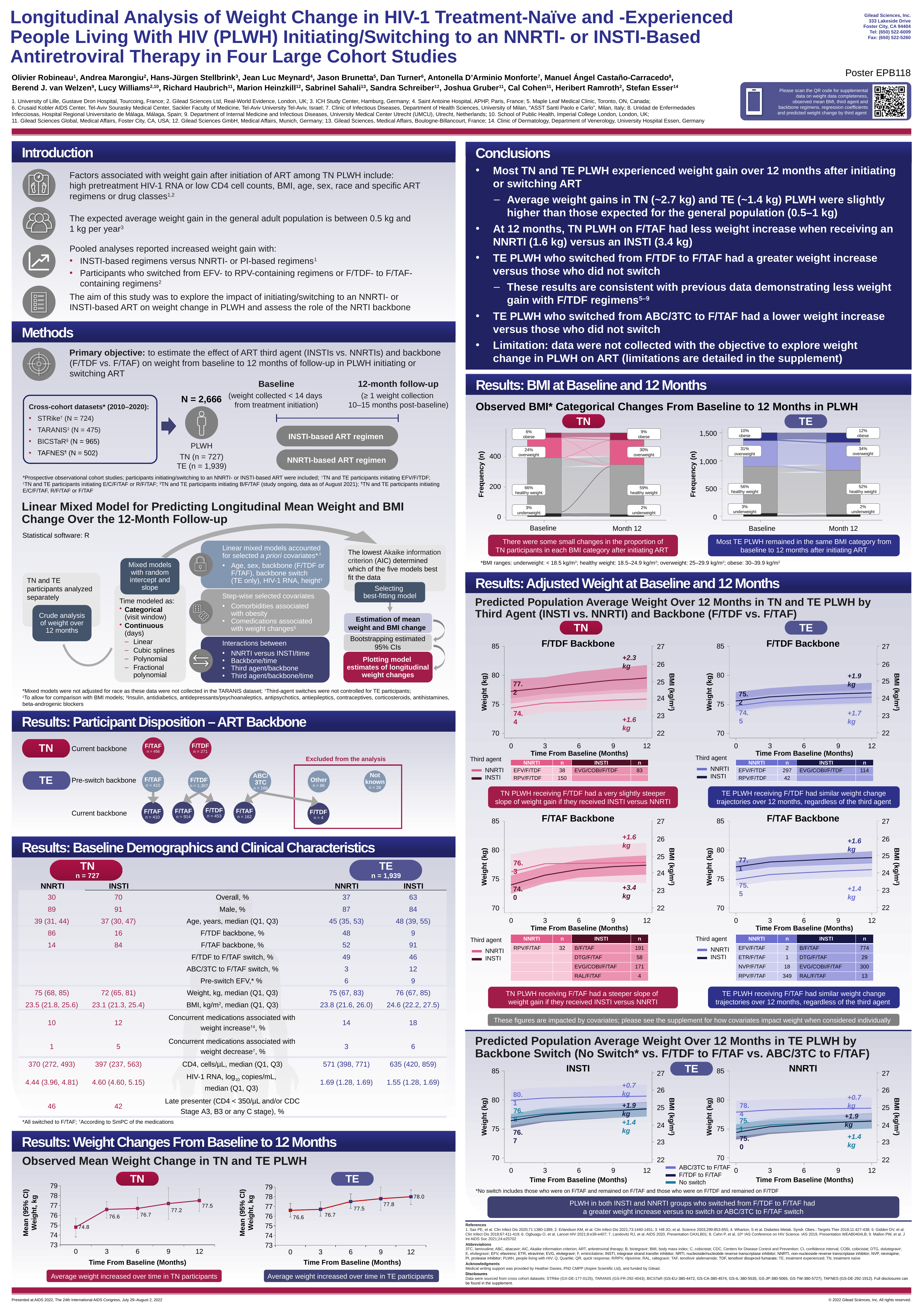
In the 'Observed Mean Weight Change in TN and TE PLWH' TN chart, what is the mean weight at month 12? 77.5 In the 'Observed Mean Weight Change in TN and TE PLWH' TN chart, how many time points are plotted? 5 In the 'Observed Mean Weight Change in TN and TE PLWH' TE chart, what is the mean weight at month 12? 78.0 What kind of chart is the 'Observed Mean Weight Change in TN and TE PLWH' TN chart? line chart In the 'Observed BMI Categorical Changes' TE chart, what percentage of participants were healthy weight at Baseline? 56% In the 'Observed Mean Weight Change in TN and TE PLWH' TE chart, does the mean weight rise or fall from month 0 to month 12? rise In the 'Predicted Population Average Weight Over 12 Months in TE PLWH by Backbone Switch' INSTI chart, what is the weight change for the F/TDF to F/TAF group? +1.9 kg In the 'Observed BMI Categorical Changes' TN chart, what percentage of participants were overweight at Month 12? 30% In the 'Observed BMI Categorical Changes' TN chart, which BMI category has the largest share at Baseline? healthy weight In the 'Observed Mean Weight Change in TN and TE PLWH' TN chart, what is the difference between the mean weight at month 12 and at month 0? 2.7 In the 'Observed Mean Weight Change in TN and TE PLWH' TN chart, what is the mean weight at month 0? 74.8 In the 'Predicted Population Average Weight' TN F/TAF Backbone chart, what is the 12-month weight change for INSTI? +3.4 kg